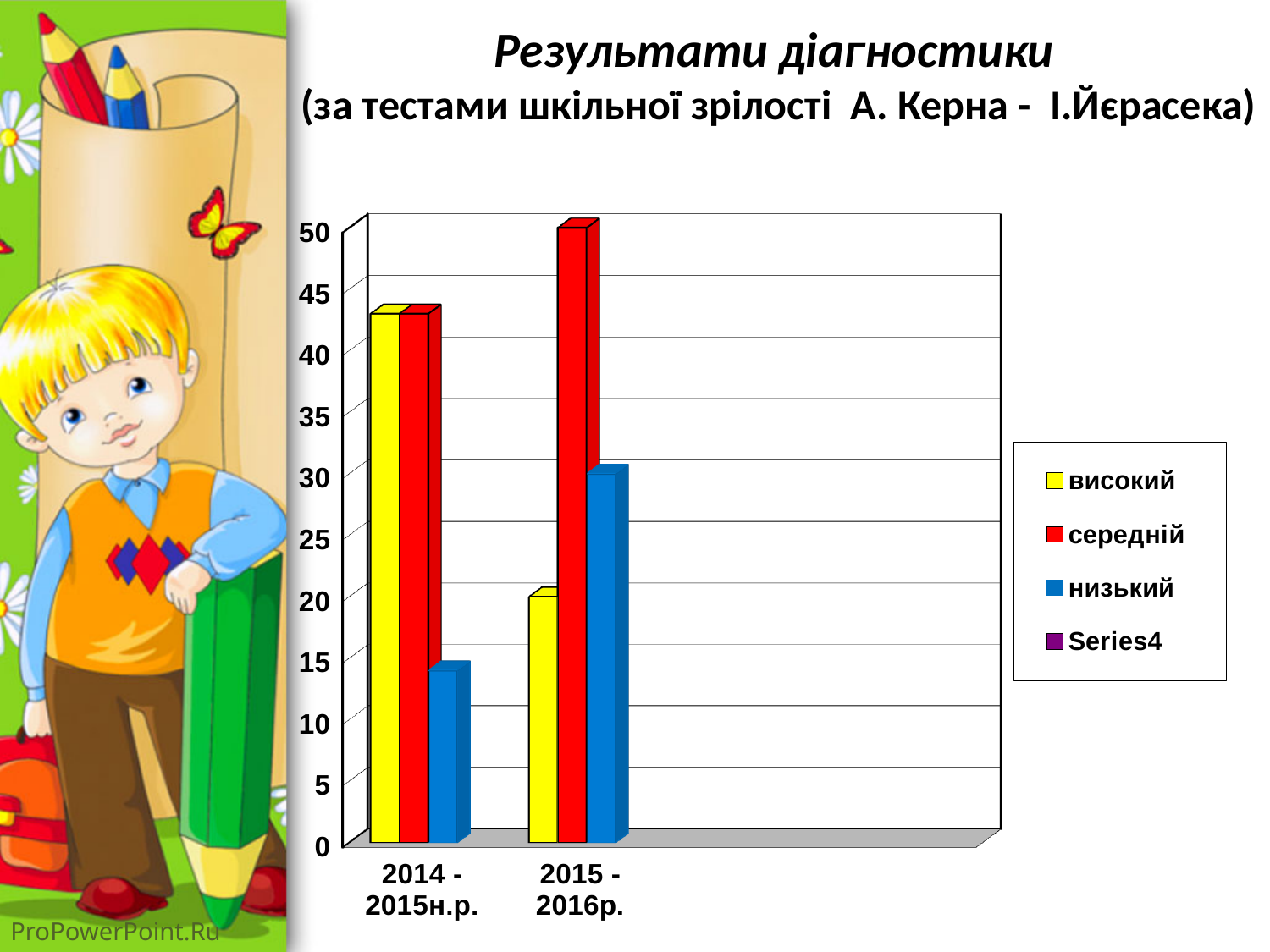
Which series has the lowest value for 2015 - 2016р.? високий Does the value for високий rise or fall from 2014 - 2015н.р. to 2015 - 2016р.? fall How many series does the legend list? 4 Is the value for високий in 2015 - 2016р. greater or less than 25? less Is the value for низький in 2014 - 2015н.р. greater or less than 10? greater What kind of chart is shown on the slide? bar chart Which series has the lowest value for 2014 - 2015н.р.? низький How many categories (school years) are shown on the x axis? 2 Is the value for середній in 2015 - 2016р. greater or less than 45? greater Which is larger: the value for низький in 2014 - 2015н.р. or in 2015 - 2016р.? 2015 - 2016р. Which series has the highest value for 2015 - 2016р.? середній